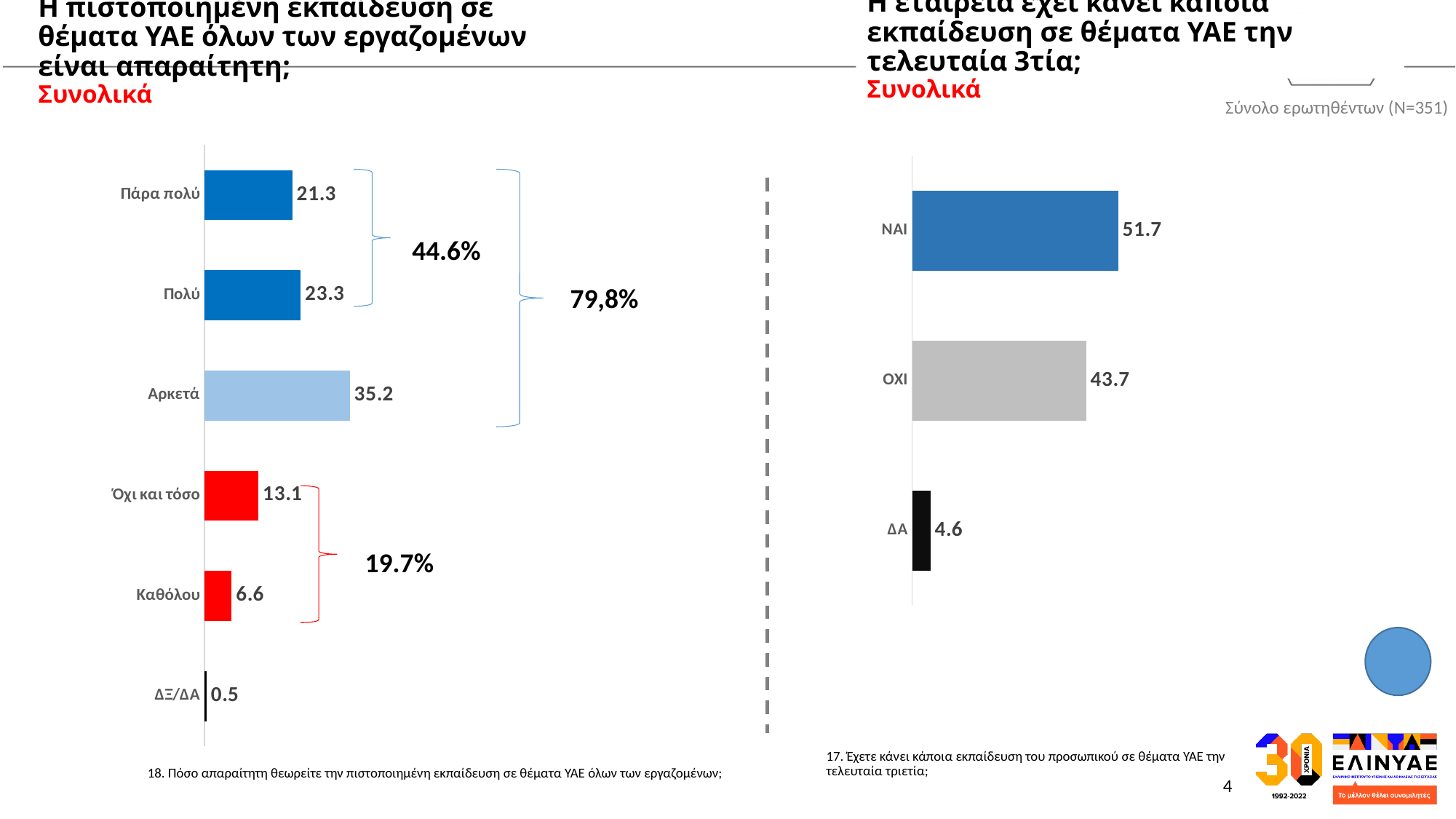
In the left chart, what is the value for Αρκετά? 35.2 In the right chart, what is the value for ΔΑ? 4.6 In the right chart, which is larger, ΝΑΙ or ΟΧΙ? ΝΑΙ In the left chart, which category has the lowest value? ΔΞ/ΔΑ In the right chart, what is the value for ΝΑΙ? 51.7 In the left chart, what combined percentage is shown by the bracket grouping Όχι και τόσο and Καθόλου? 19.7% In the left chart, what is the difference between the values for Πολύ and Πάρα πολύ? 2.0 In the left chart, how many categories are shown? 6 In the right chart, what is the difference between the values for ΝΑΙ and ΟΧΙ? 8.0 In the left chart, which category has the highest value? Αρκετά What type of chart is the right chart? Bar chart In the left chart, what is the value for Καθόλου? 6.6